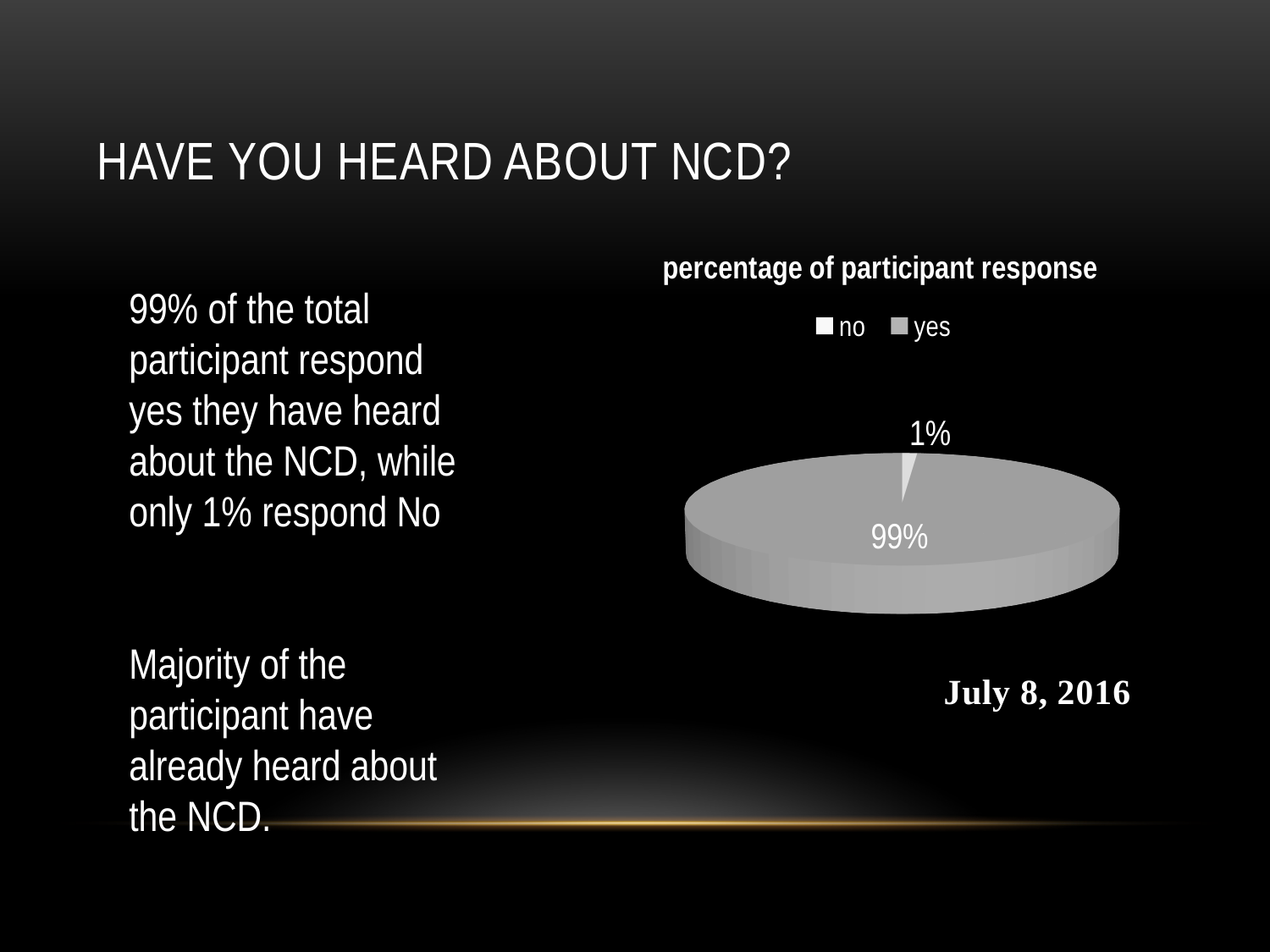
What are the two legend entries of the chart? no and yes Which response has the smallest share of the pie? no Which is larger, the share for yes or the share for no? yes What is the chart's title? percentage of participant response What percentage of participants responded yes? 99% What share of the pie does the yes slice represent? 99% How many slices does the pie chart have? 2 Which response has the largest share of the pie? yes What is the difference between the yes and no percentages? 98% How many entries does the legend list? 2 What kind of chart is shown on the slide? pie chart What percentage of participants responded no? 1%